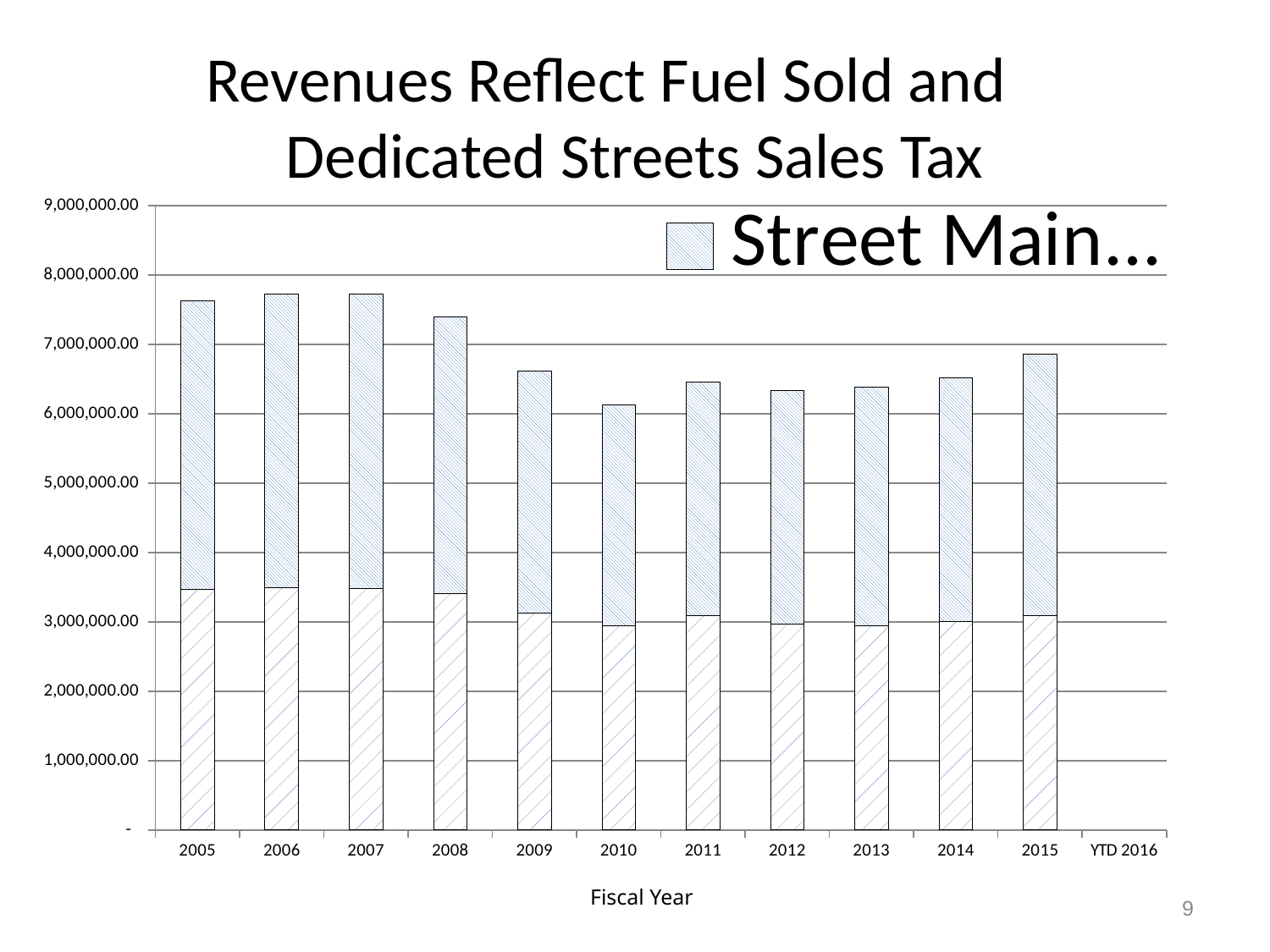
What kind of chart is shown on the slide? Stacked bar chart Is the total bar height for 2009 greater or less than 6,000,000.00? greater What is the title of the x axis? Fiscal Year How many fiscal years have a bar plotted in the chart? 11 Which fiscal year with a plotted bar has the lowest total bar height? 2010 Is the total bar height for 2005 greater or less than 7,000,000.00? greater Is the total bar height for 2015 greater or less than 7,000,000.00? less How many fiscal year categories are labelled on the x axis? 12 Which has the larger total bar height, 2005 or 2010? 2005 Do the total bar heights rise or fall from 2005 to 2010? fall